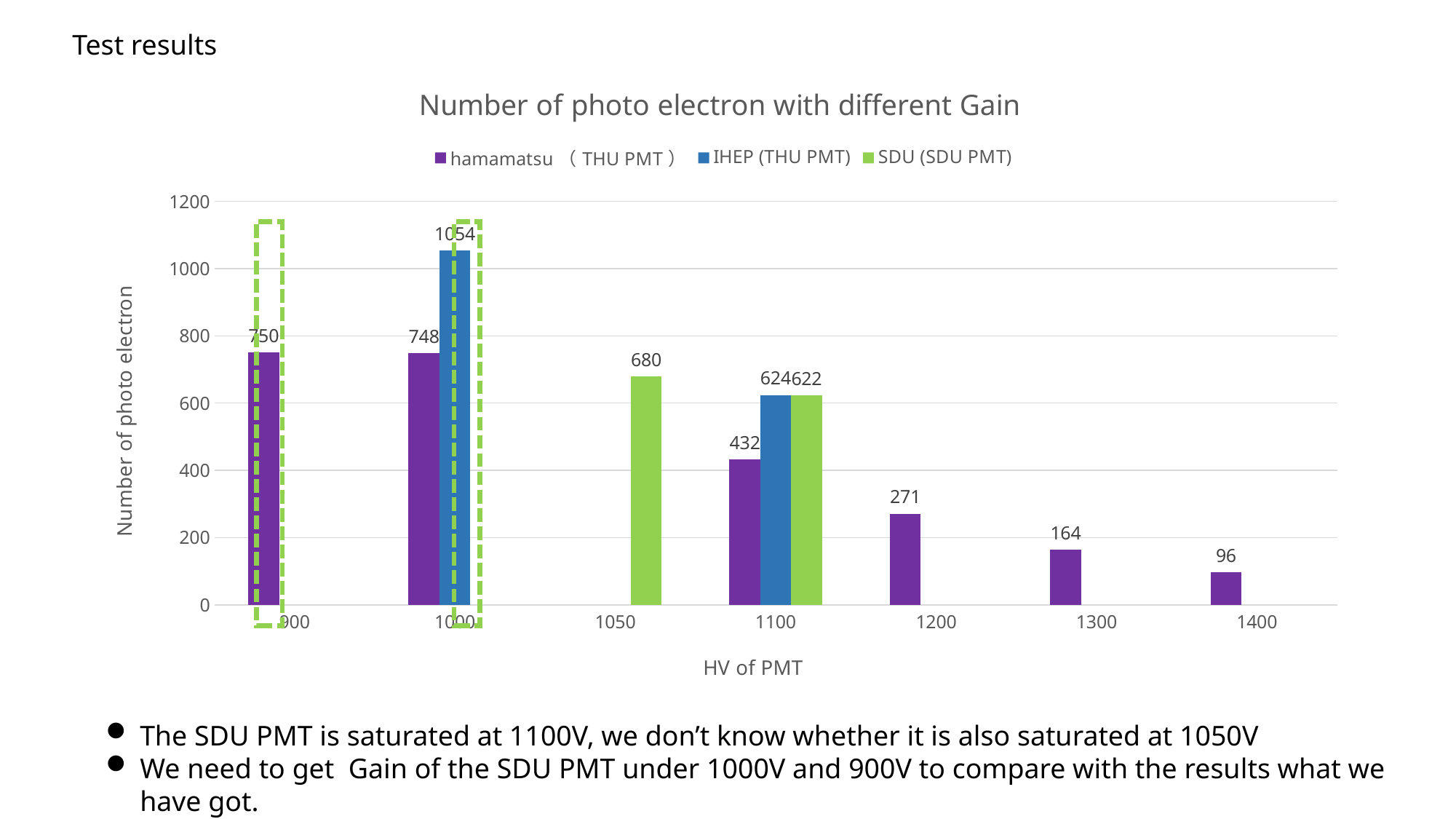
What is the value for SDU (SDU PMT) at 1050 V? 680 How many series does the legend list? 3 What kind of chart is shown on the slide? Bar chart What is the difference between the hamamatsu (THU PMT) values at 1200 V and 1300 V? 107 At which HV value is the hamamatsu (THU PMT) bar lowest? 1400 What is the value for hamamatsu (THU PMT) at 900 V? 750 What is the difference between the IHEP (THU PMT) and hamamatsu (THU PMT) values at 1000 V? 306 Do the hamamatsu (THU PMT) values rise or fall from 1100 V to 1400 V? Fall What is the value for hamamatsu (THU PMT) at 1100 V? 432 What is the value for IHEP (THU PMT) at 1000 V? 1054 At 1100 V, which series has the larger value: IHEP (THU PMT) or SDU (SDU PMT)? IHEP (THU PMT) How many HV categories are shown on the x axis? 7